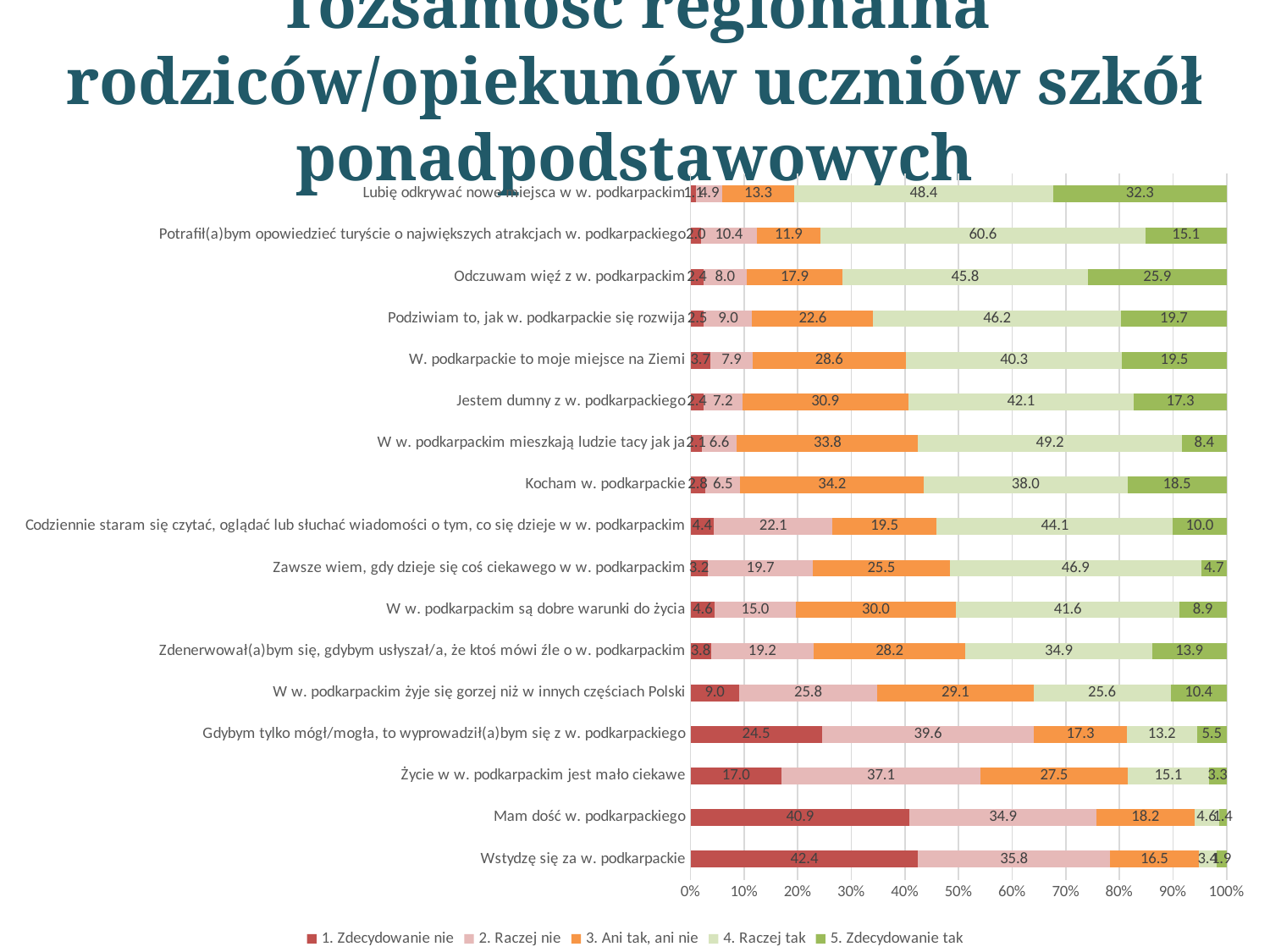
What is the value of "5. Zdecydowanie tak" for "Odczuwam więź z w. podkarpackim"? 25.9 What type of chart is shown on the slide? stacked bar chart Which is larger: the "2. Raczej nie" value for "Gdybym tylko mógł/mogła, to wyprowadził(a)bym się z w. podkarpackiego" or for "Życie w w. podkarpackim jest mało ciekawe"? Gdybym tylko mógł/mogła, to wyprowadził(a)bym się z w. podkarpackiego How many series does the legend list? 5 Which statement has the highest value for "1. Zdecydowanie nie"? Wstydzę się za w. podkarpackie Which statement has the highest value for "4. Raczej tak"? Potrafił(a)bym opowiedzieć turyście o największych atrakcjach w. podkarpackiego What is the value of "4. Raczej tak" for "Potrafił(a)bym opowiedzieć turyście o największych atrakcjach w. podkarpackiego"? 60.6 How many statements (categories) are plotted on the chart? 17 What is the value of "3. Ani tak, ani nie" for "Kocham w. podkarpackie"? 34.2 What is the difference between the "1. Zdecydowanie nie" values for "Mam dość w. podkarpackiego" and "Życie w w. podkarpackim jest mało ciekawe"? 23.9 Which legend entry is shown in orange? 3. Ani tak, ani nie What is the value of "1. Zdecydowanie nie" for "Wstydzę się za w. podkarpackie"? 42.4